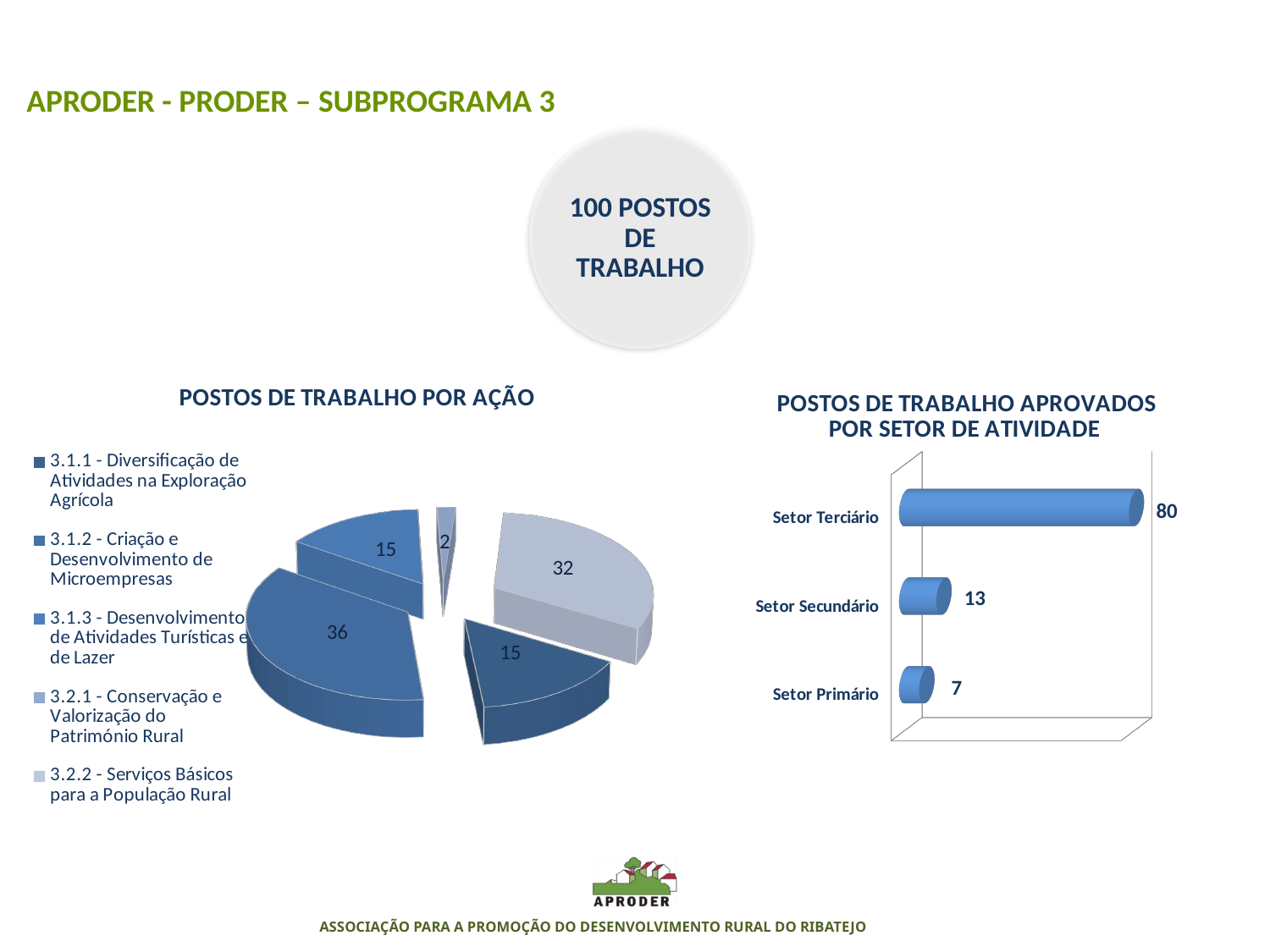
In the chart 'POSTOS DE TRABALHO APROVADOS POR SETOR DE ATIVIDADE', what is the value for Setor Secundário? 13 In the pie chart 'POSTOS DE TRABALHO POR AÇÃO', what is the value of the largest slice? 36 How many entries does the legend of the pie chart 'POSTOS DE TRABALHO POR AÇÃO' list? 5 In the chart 'POSTOS DE TRABALHO APROVADOS POR SETOR DE ATIVIDADE', what is the value for Setor Terciário? 80 What type of chart is 'POSTOS DE TRABALHO POR AÇÃO'? Pie chart In the pie chart 'POSTOS DE TRABALHO POR AÇÃO', what is the value of the smallest slice? 2 In the chart 'POSTOS DE TRABALHO APROVADOS POR SETOR DE ATIVIDADE', how many sectors are shown? 3 In the chart 'POSTOS DE TRABALHO APROVADOS POR SETOR DE ATIVIDADE', what is the value for Setor Primário? 7 What type of chart is 'POSTOS DE TRABALHO APROVADOS POR SETOR DE ATIVIDADE'? Bar chart In the chart 'POSTOS DE TRABALHO APROVADOS POR SETOR DE ATIVIDADE', which sector has the lowest value? Setor Primário In the chart 'POSTOS DE TRABALHO APROVADOS POR SETOR DE ATIVIDADE', which sector has the highest value? Setor Terciário In the chart 'POSTOS DE TRABALHO APROVADOS POR SETOR DE ATIVIDADE', what is the difference between Setor Terciário and Setor Secundário? 67